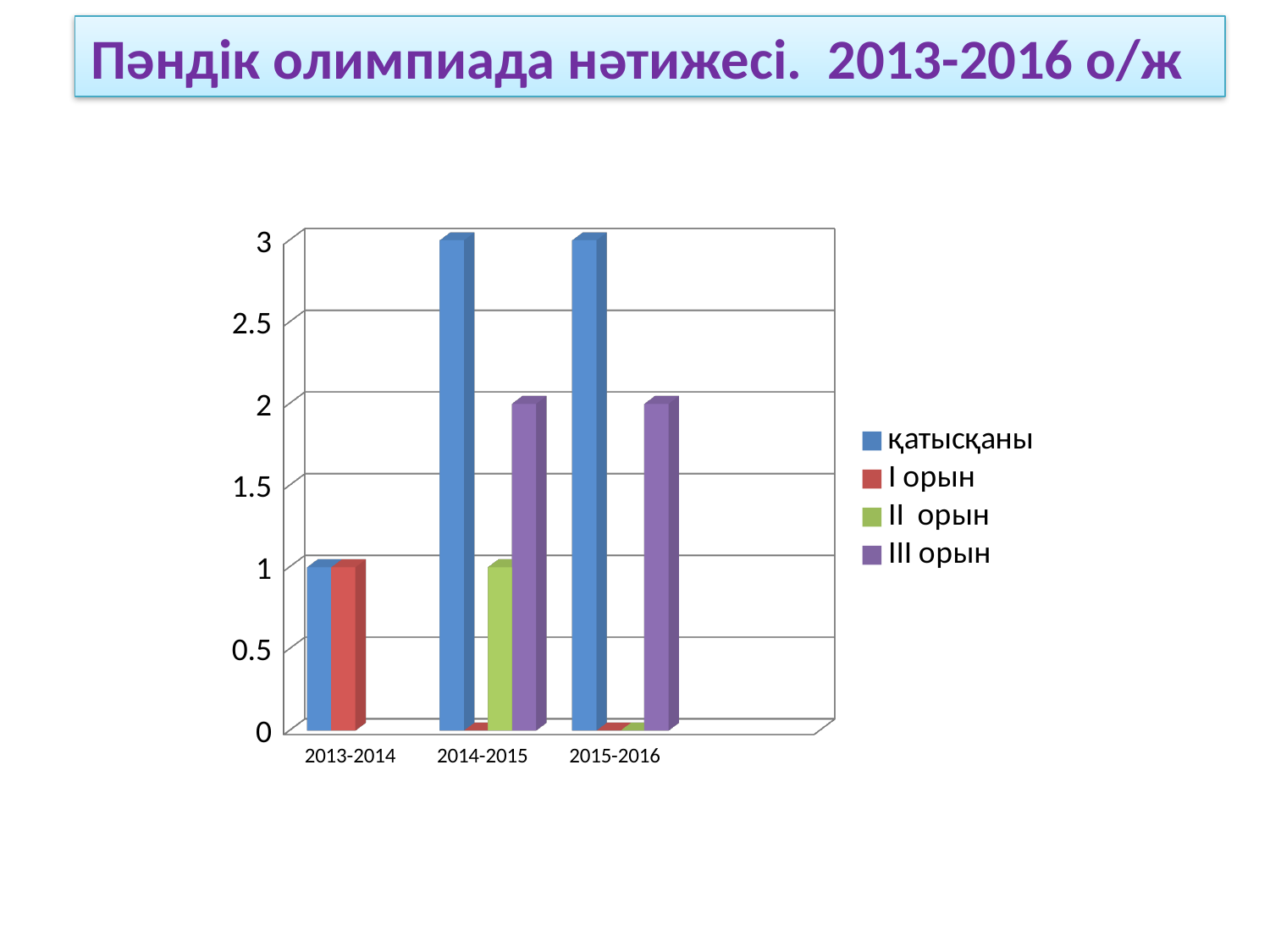
What is the value of қатысқаны for 2013-2014? 1 What is the value of II орын for 2014-2015? 1 Which category has the lowest value for қатысқаны? 2013-2014 What is the difference between қатысқаны and III орын for 2015-2016? 1 How many categories are shown on the x axis? 3 Is the value of III орын for 2014-2015 greater or less than 1.5? greater What kind of chart is shown on the slide? bar chart What is the value of III орын for 2015-2016? 2 What is the title of the slide? Пәндік олимпиада нәтижесі. 2013-2016 о/ж What is the value of қатысқаны for 2014-2015? 3 Which is larger for 2014-2015: қатысқаны or III орын? қатысқаны How many series does the legend list? 4